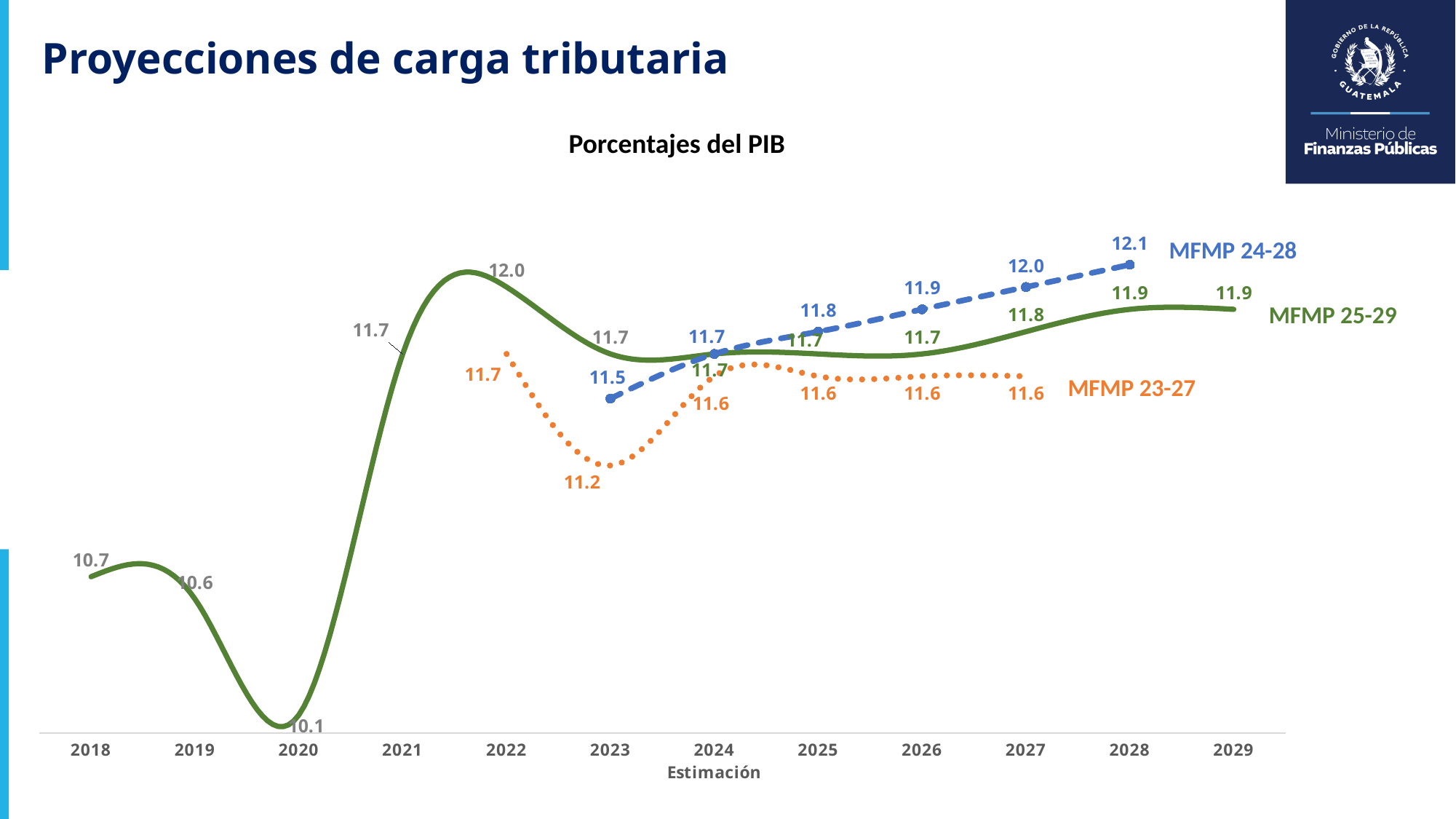
Does the MFMP 24-28 series rise or fall from 2023 to 2028? rise In which year does the MFMP 25-29 series reach its highest value? 2022 What is the difference between the MFMP 24-28 value in 2028 and its value in 2023? 0.6 What is the value of the MFMP 23-27 series in 2023? 11.2 How many years are shown on the x axis? 12 What is the value of the MFMP 24-28 series in 2028? 12.1 What is the subtitle shown above the chart? Porcentajes del PIB Which series has the higher value in 2027, MFMP 24-28 or MFMP 23-27? MFMP 24-28 How many series are plotted on the chart? 3 In which year does the MFMP 25-29 series reach its lowest value? 2020 What is the value of the MFMP 25-29 series in 2020? 10.1 What type of chart is shown on the slide? line chart